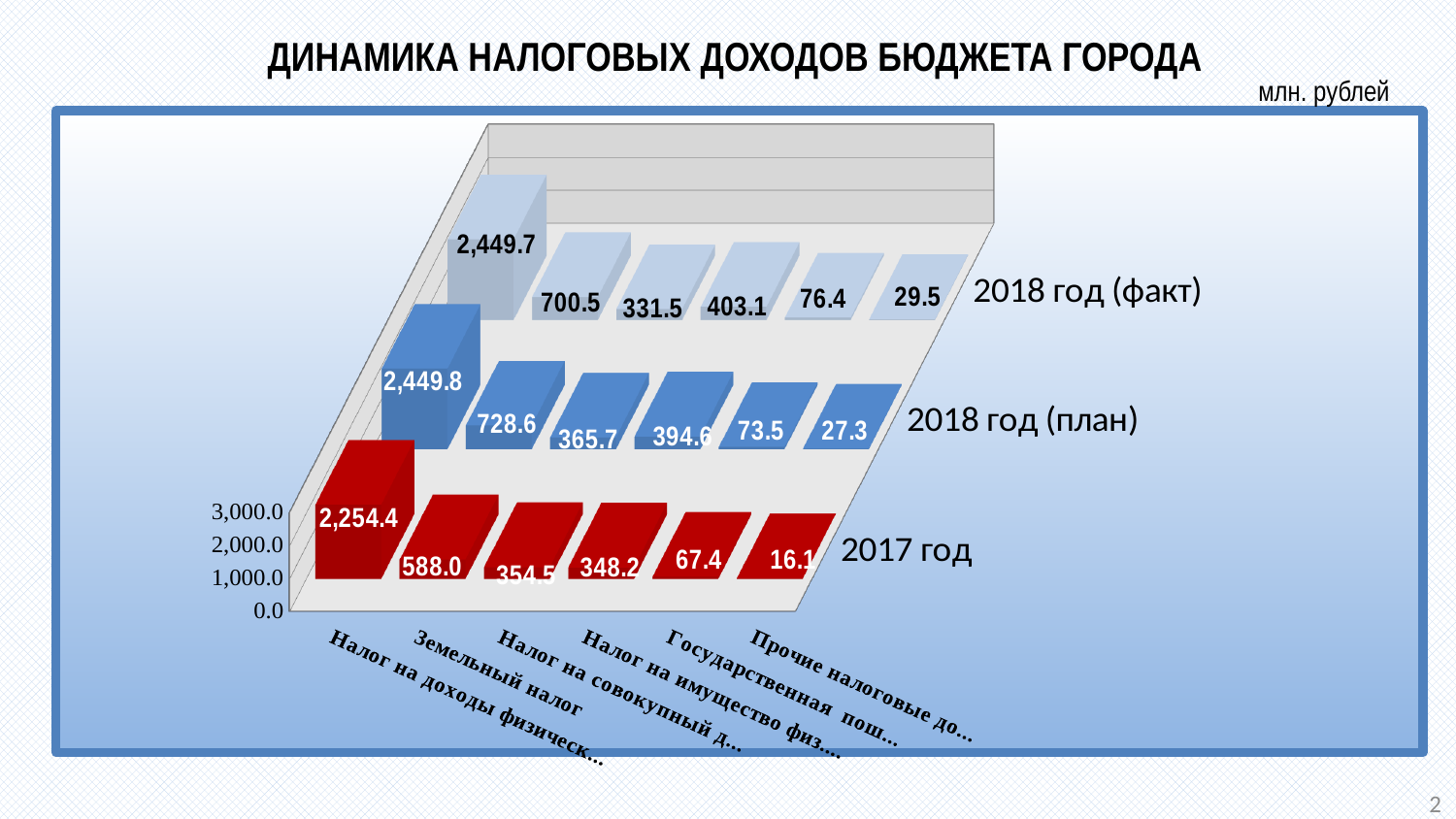
How many series does the chart show? 3 Which category has the lowest value in the 2018 год (план) series? Прочие налоговые до... What is the value for Земельный налог in the 2018 год (план) series? 728.6 What is the value for the last category (Прочие налоговые до...) in the 2017 год series? 16.1 How many categories are shown on the x axis of the chart? 6 What is the difference between the 2018 год (план) and 2018 год (факт) values for the first category (Налог на доходы физическ...)? 0.1 What is the value for Земельный налог in the 2018 год (факт) series? 700.5 What is the value for Земельный налог in the 2017 год series? 588.0 What is the largest value shown in the 2018 год (факт) series? 2,449.7 By how much does the 2018 год (план) value for Земельный налог exceed the 2017 год value? 140.6 For Земельный налог, which is larger: the 2018 год (план) value or the 2018 год (факт) value? 2018 год (план) What unit of measurement is indicated for the chart values? млн. рублей